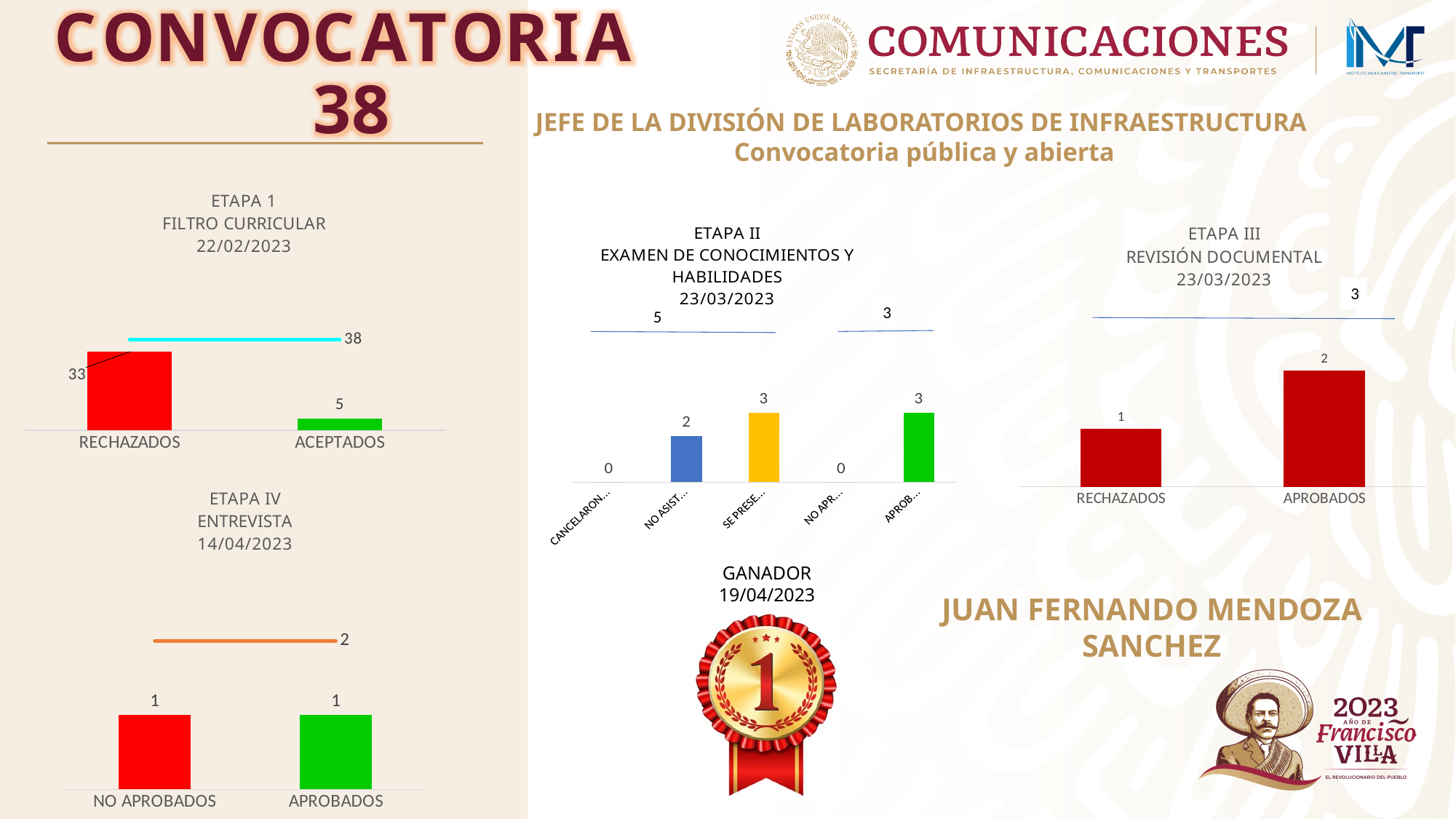
What kind of chart is the ETAPA 1 FILTRO CURRICULAR chart? Combination bar and line chart In the ETAPA 1 FILTRO CURRICULAR chart, which category is higher, RECHAZADOS or ACEPTADOS? RECHAZADOS In the ETAPA III REVISIÓN DOCUMENTAL chart, what is the value for RECHAZADOS? 1 In the ETAPA IV ENTREVISTA chart, how many categories are shown on the x axis? 2 In the ETAPA III REVISIÓN DOCUMENTAL chart, which category has the highest value? APROBADOS In the ETAPA IV ENTREVISTA chart, what is the value for NO APROBADOS? 1 In the ETAPA 1 FILTRO CURRICULAR chart, what is the difference between RECHAZADOS and ACEPTADOS? 28 In the ETAPA 1 FILTRO CURRICULAR chart, what is the value for RECHAZADOS? 33 In the ETAPA III REVISIÓN DOCUMENTAL chart, what is the value for APROBADOS? 2 In the ETAPA 1 FILTRO CURRICULAR chart, what is the value for ACEPTADOS? 5 In the ETAPA II EXAMEN DE CONOCIMIENTOS Y HABILIDADES chart, what is the value of the yellow bar (SE PRESE…)? 3 In the ETAPA II EXAMEN DE CONOCIMIENTOS Y HABILIDADES chart, how many bar categories are shown on the x axis? 5